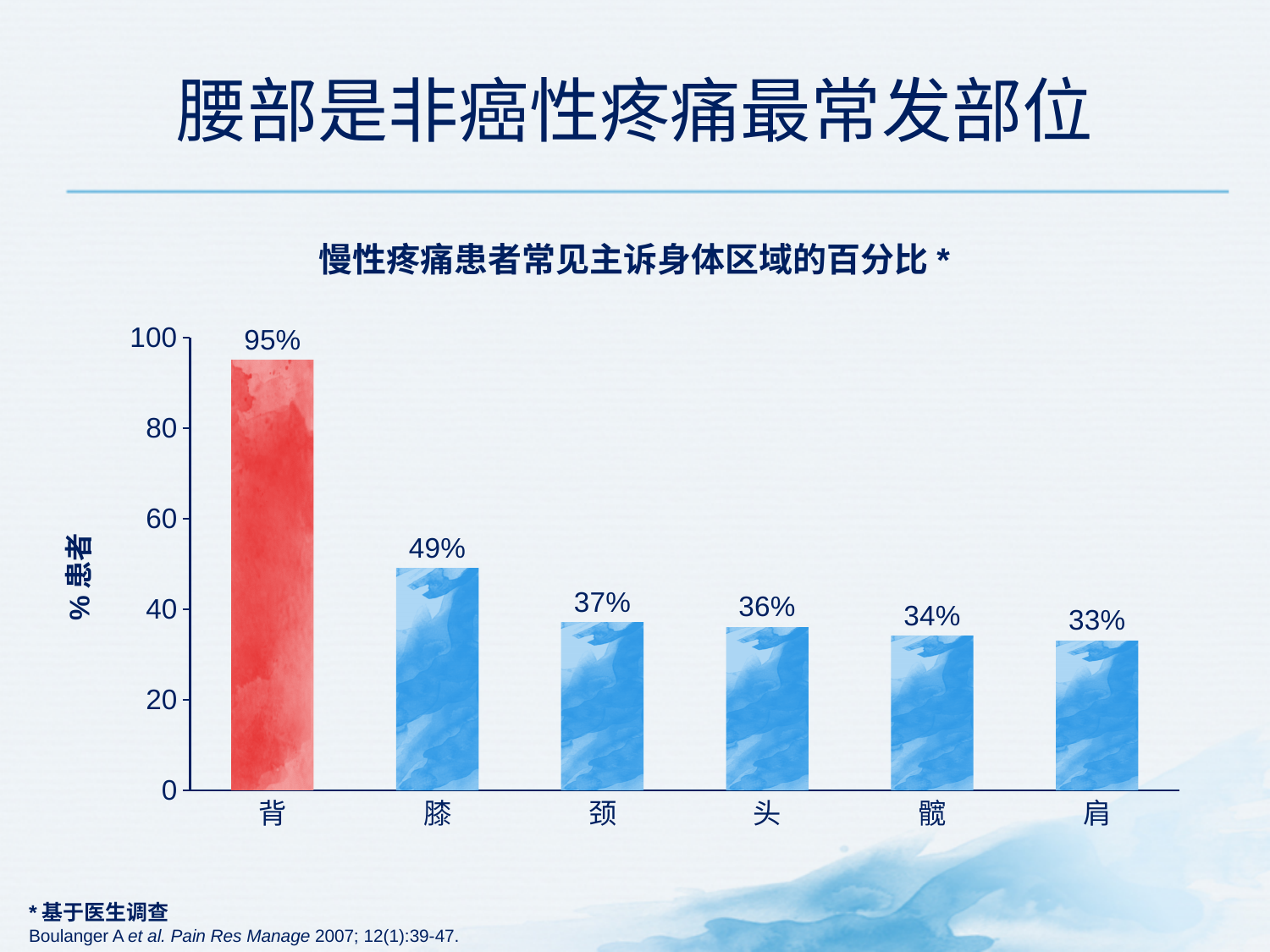
What is the value for 肩 (shoulder)? 33% What is the value for 膝 (knee)? 49% Which body region has the highest percentage of patients? 背 Which is larger, the value for 颈 or the value for 髋? 颈 What kind of chart is shown on the slide? bar chart Is the value for 头 greater or less than 40? less How many body regions are shown on the x axis? 6 Which bar is coloured red rather than blue? 背 What is the difference between the values for 背 and 膝? 46% What is the value for 背 (back)? 95% What is the difference between the values for 颈 and 肩? 4% Which body region has the lowest percentage of patients? 肩